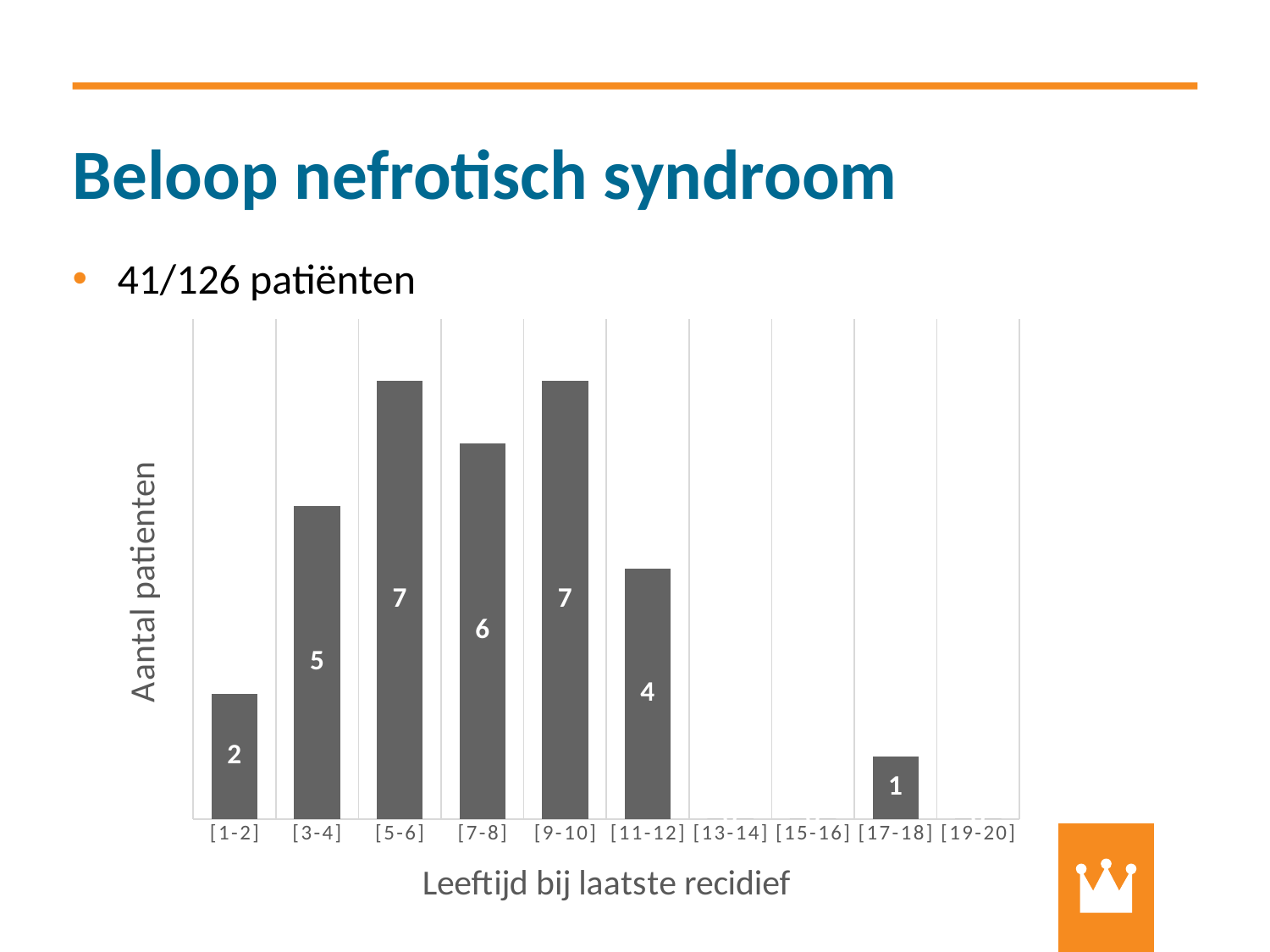
What is the value for the [17-18] category? 1 Which has a larger value, [3-4] or [7-8]? [7-8] What kind of chart is shown on the slide? Bar chart What is the title of the x axis? Leeftijd bij laatste recidief What is the highest value shown on any bar in the chart? 7 What is the value for the [11-12] category? 4 How many categories are shown on the x axis? 10 What is the value for the [7-8] category? 6 Which has a larger value, [11-12] or [17-18]? [11-12] What is the value for the [1-2] category? 2 What is the difference between the values for [5-6] and [1-2]? 5 What is the difference between the values for [9-10] and [11-12]? 3